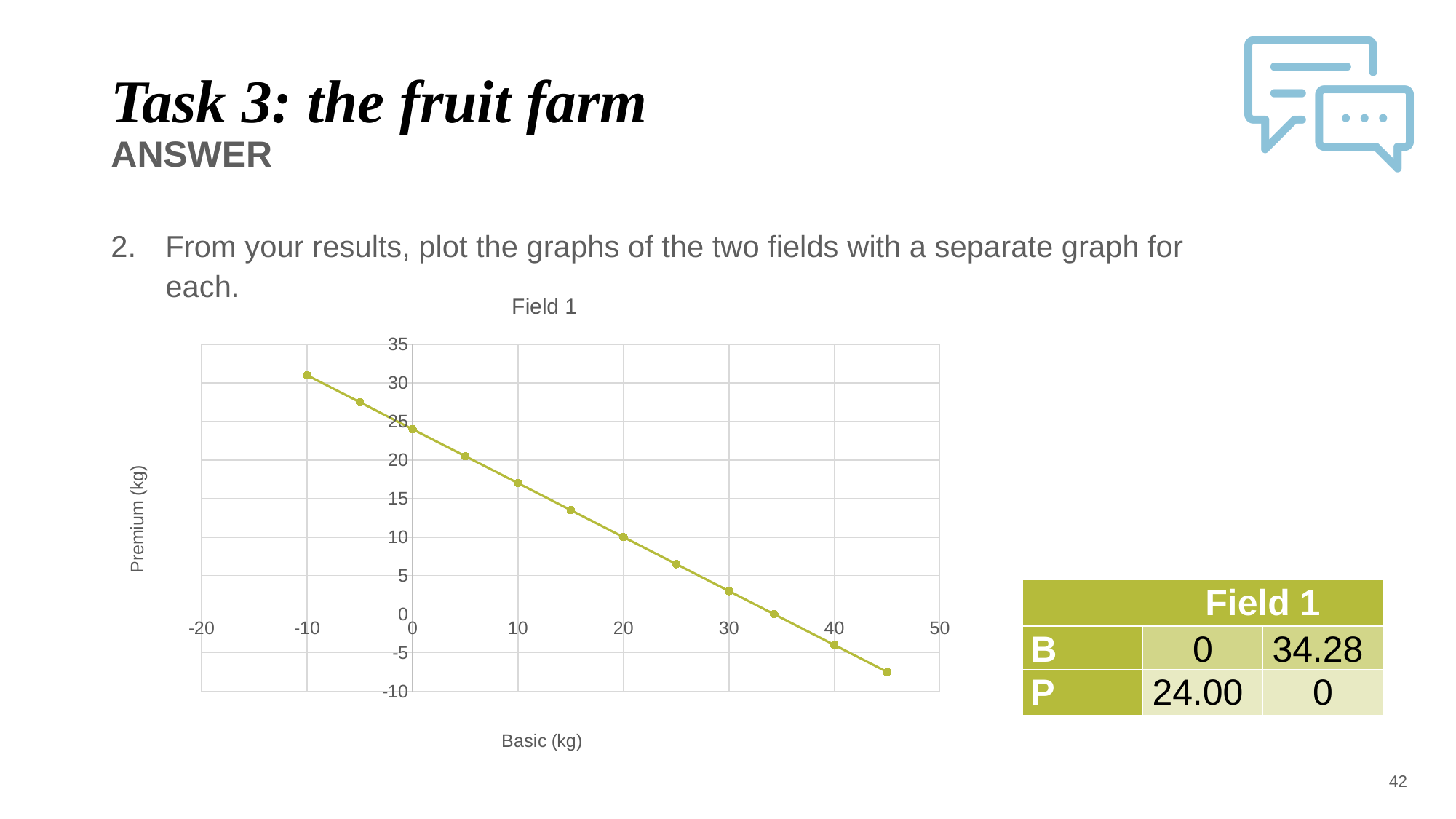
Do the values on the chart rise or fall as Basic (kg) increases? fall Is the Premium (kg) value at Basic (kg) = 40 greater or less than 0? less At which Basic (kg) value is the plotted Premium (kg) lowest? 45 At which Basic (kg) value is the plotted Premium (kg) highest? -10 Is the Premium (kg) value at Basic (kg) = 10 greater or less than 15? greater What is the label of the x axis of the chart? Basic (kg) Which has the larger Premium (kg) value: Basic (kg) = 0 or Basic (kg) = 20? Basic (kg) = 0 What kind of chart is shown on the slide? line chart Is the Premium (kg) value at Basic (kg) = 30 greater or less than 5? less What is the Premium (kg) value plotted at Basic (kg) = 20? 10 How many data points are plotted on the chart? 12 What is the title of the chart? Field 1